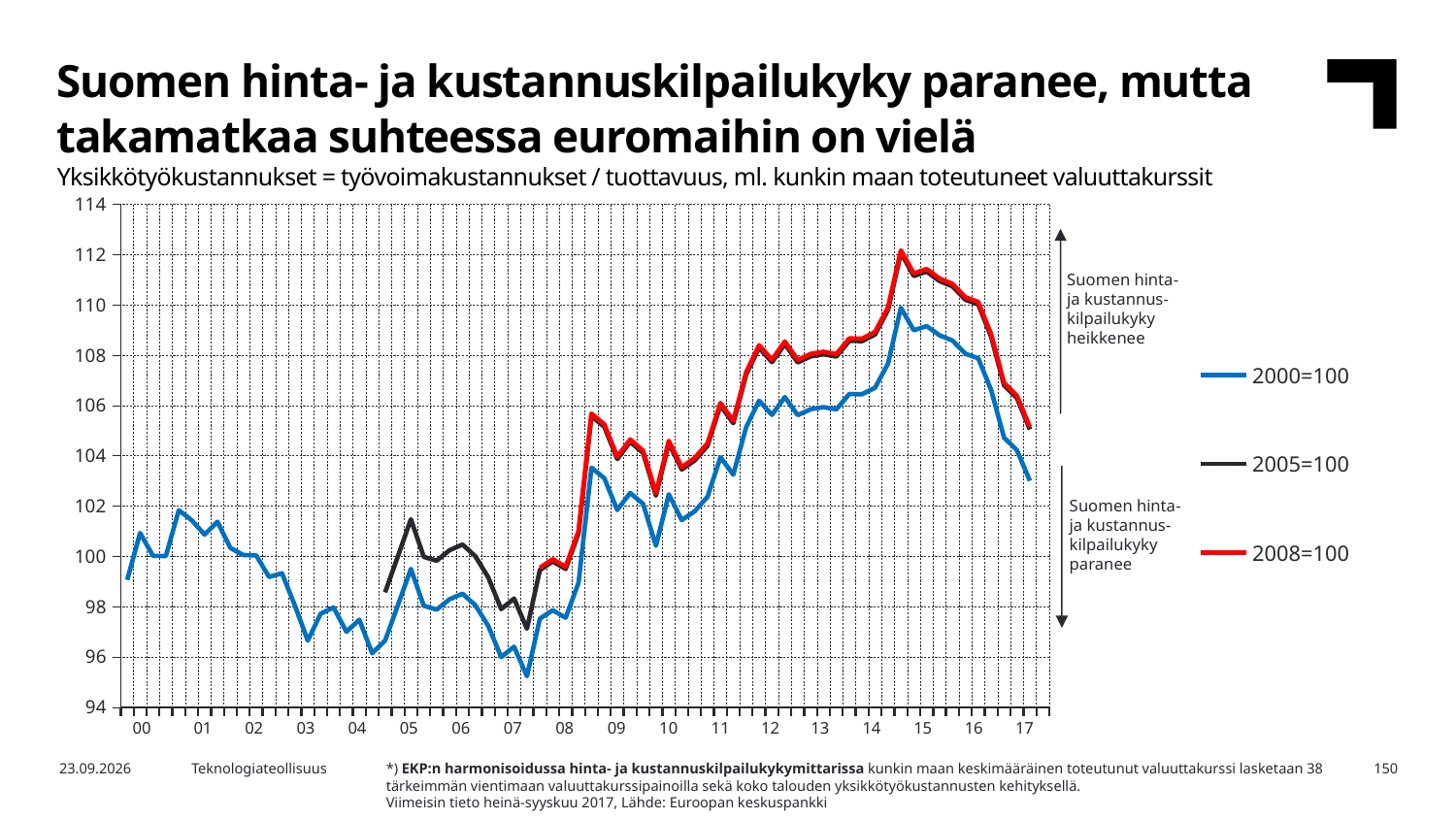
What colour is the 2008=100 series line? red Is the peak value of the 2008=100 series around 2015 greater or less than 110? greater How many series does the legend list? 3 Is the peak value of the 2000=100 series around 2015 greater or less than 108? greater What kind of chart is shown on the slide? line chart How many year labels are shown on the x axis? 18 What are the three series named in the legend? 2000=100, 2005=100, 2008=100 Is the final value of the 2008=100 series in 2017 greater or less than 106? less Around 2015, which series has the higher value, 2000=100 or 2008=100? 2008=100 Does the 2000=100 series rise or fall between 2015 and 2017? fall